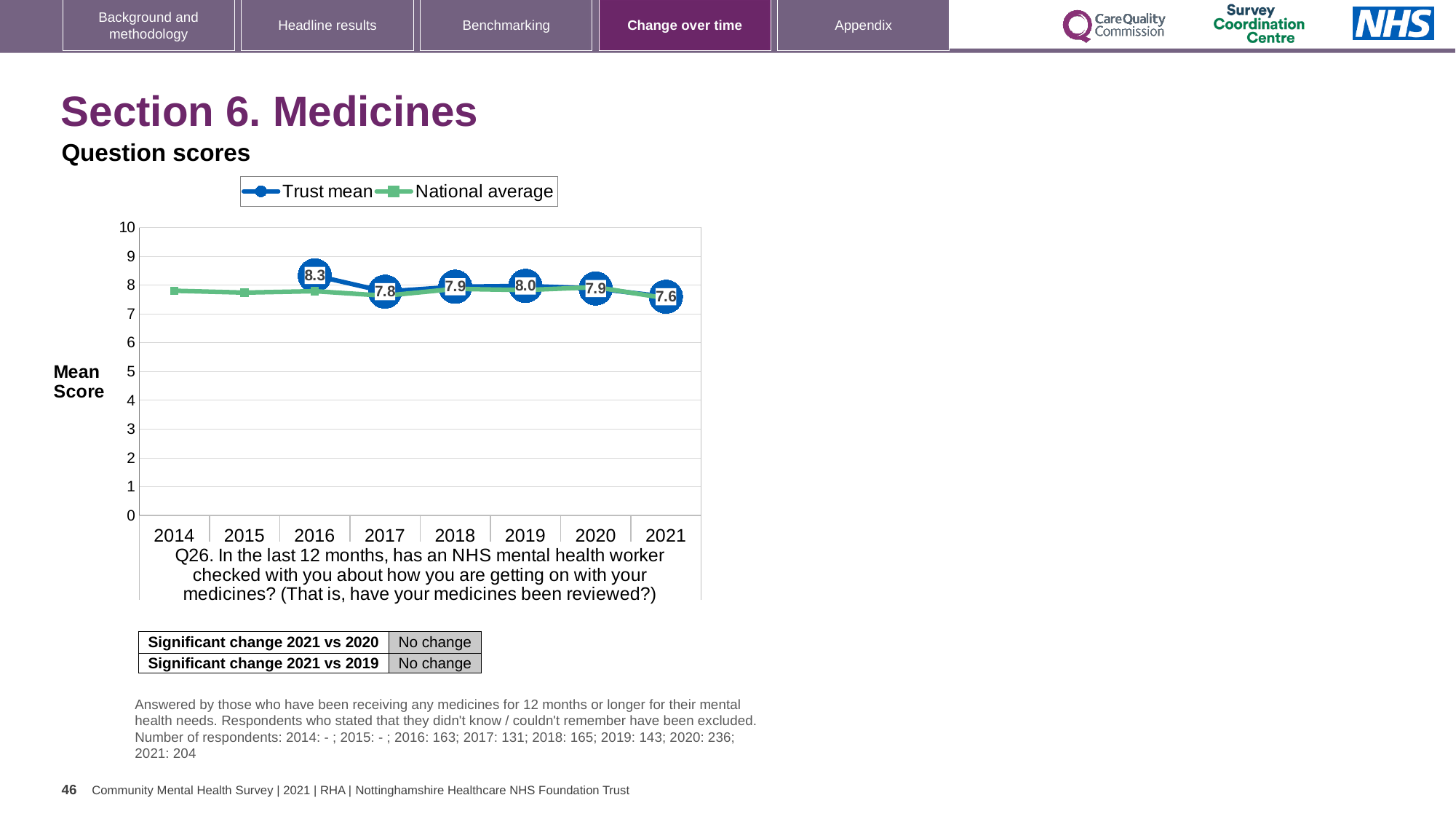
How many years are shown on the x axis of the chart? 8 What is the Trust mean score for 2019? 8.0 Does the Trust mean score rise or fall from 2019 to 2021? fall Which year has the higher Trust mean score, 2016 or 2017? 2016 What is the Trust mean score for 2016? 8.3 Is the National average value for 2014 greater or less than 5? greater In which year is the Trust mean score lowest? 2021 What kind of chart is shown on the slide? line chart What is the Trust mean score for 2021? 7.6 How many series does the chart legend list? 2 In which year is the Trust mean score highest? 2016 What is the difference between the Trust mean score in 2016 and in 2021? 0.7